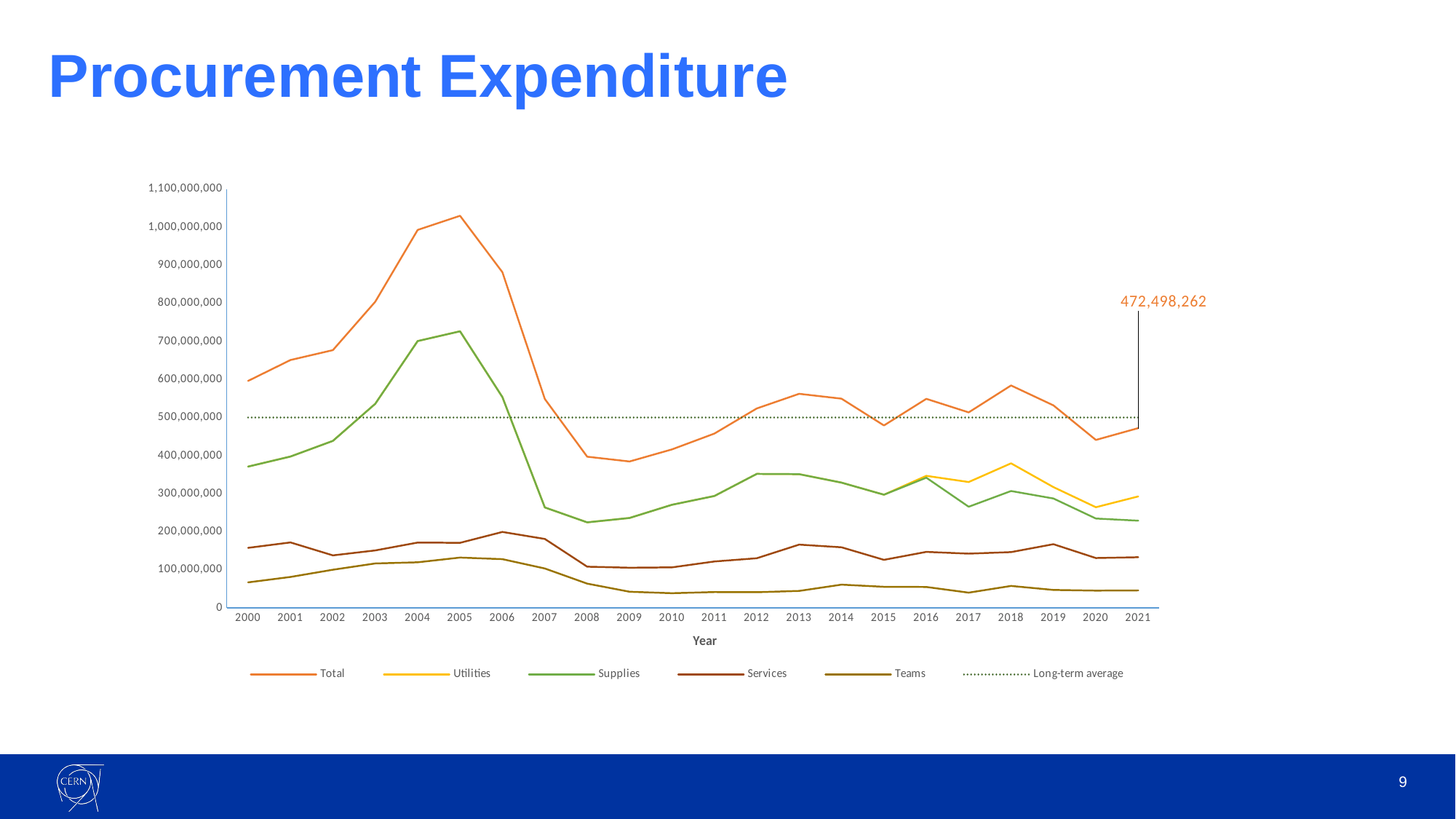
How many years are plotted along the x axis? 22 Is the value for Total in 2020 greater or less than 500,000,000? less In 2005, which is larger: Supplies or Services? Supplies Is the value for Teams in 2009 greater or less than 100,000,000? less Does the Total series rise or fall from 2005 to 2008? fall In which year is the Supplies series at its highest? 2005 What is the value of Total in 2021? 472,498,262 What kind of chart is shown on the slide? line chart Is the value for Supplies in 2008 greater or less than 300,000,000? less In 2018, which is larger: Utilities or Supplies? Utilities In which year is the Total series at its highest? 2005 How many series does the legend list? 6